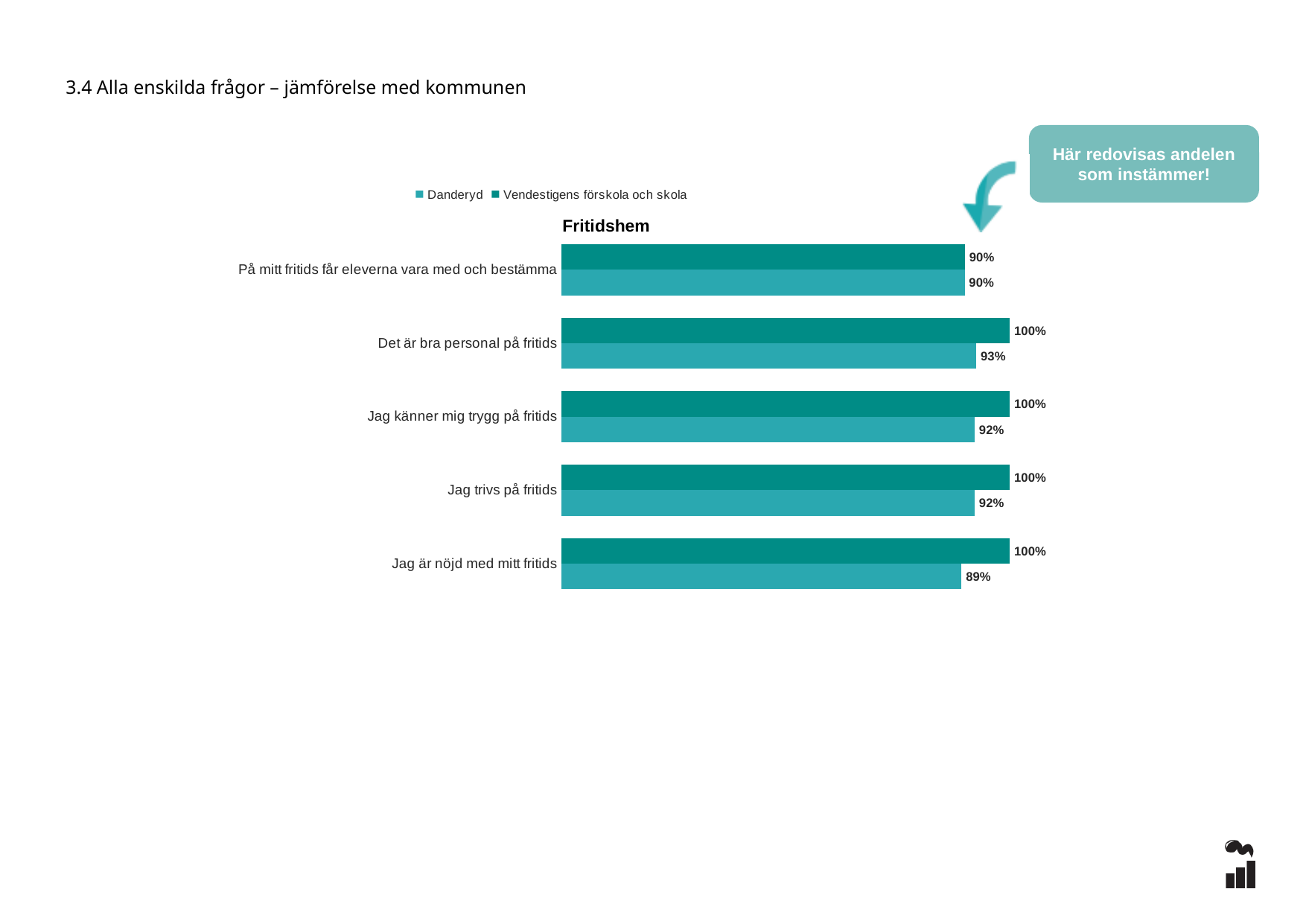
What is the value for Danderyd for 'Jag är nöjd med mitt fritids'? 89% Which category has the lowest value for Danderyd? Jag är nöjd med mitt fritids How many series does the legend list? 2 What is the value for Vendestigens förskola och skola for 'Det är bra personal på fritids'? 100% What type of chart is shown on the slide? bar chart What is the value for Vendestigens förskola och skola for 'På mitt fritids får eleverna vara med och bestämma'? 90% For 'Jag trivs på fritids', which series has the larger value, Danderyd or Vendestigens förskola och skola? Vendestigens förskola och skola What is the title of the chart? Fritidshem How many categories (questions) are shown in the chart? 5 What is the value for Danderyd for 'Det är bra personal på fritids'? 93% What is the difference between Vendestigens förskola och skola and Danderyd for 'Jag känner mig trygg på fritids'? 8% What is the difference between Vendestigens förskola och skola and Danderyd for 'Jag är nöjd med mitt fritids'? 11%